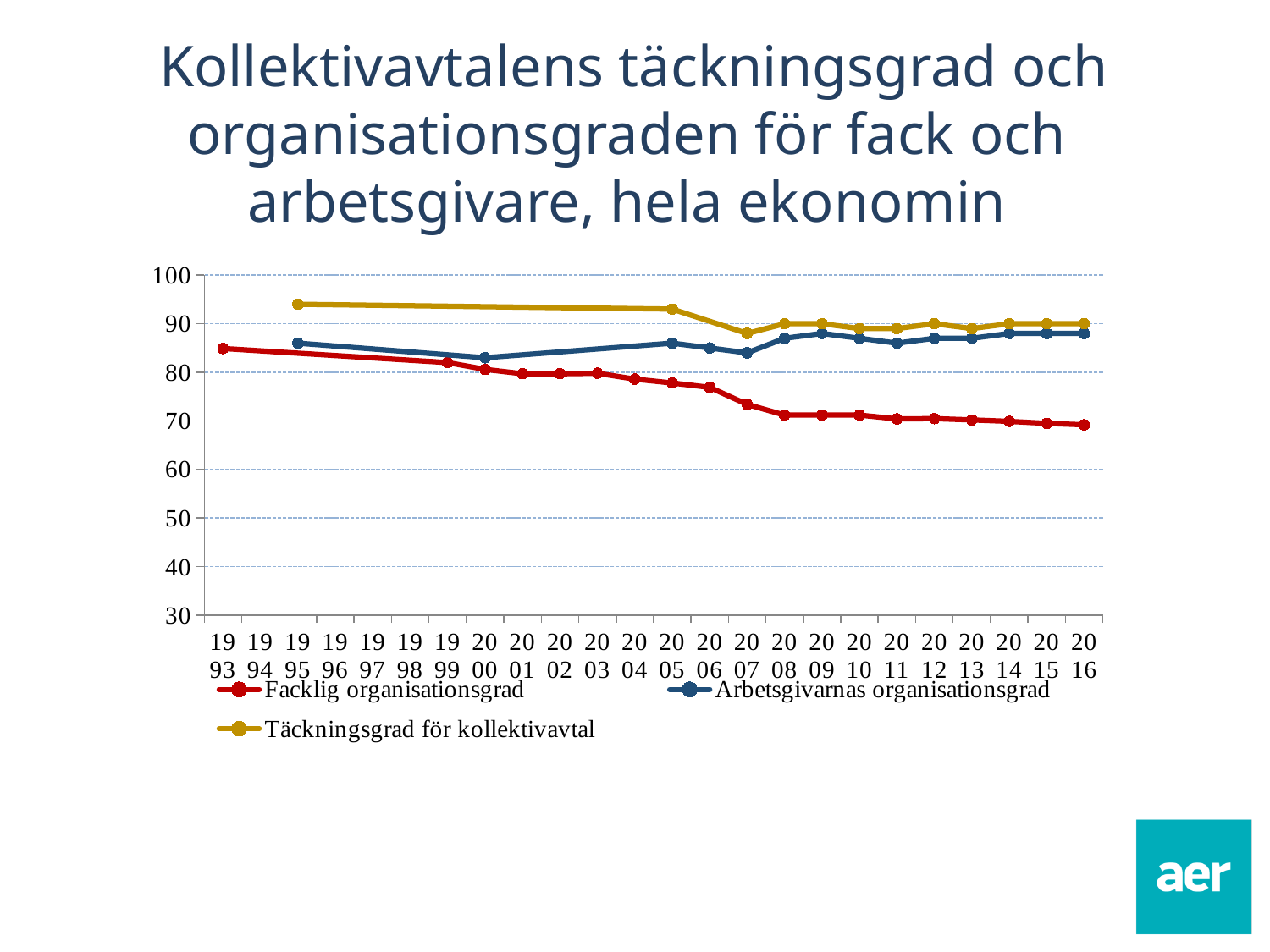
What is the first year shown on the x axis? 1993 What kind of chart is shown on the slide? line chart Does the Facklig organisationsgrad line rise or fall from 1993 to 2016? fall Is the value for Täckningsgrad för kollektivavtal in 1995 greater or less than 90? greater Which series has the highest value in 2016? Täckningsgrad för kollektivavtal Which series is drawn in red? Facklig organisationsgrad How many series does the legend list? 3 In 2010, which is larger: Arbetsgivarnas organisationsgrad or Facklig organisationsgrad? Arbetsgivarnas organisationsgrad Which series has the lowest value in 2016? Facklig organisationsgrad How many years are shown on the x axis? 24 Is the value for Arbetsgivarnas organisationsgrad in 2000 greater or less than 80? greater Is the value for Facklig organisationsgrad in 2008 greater or less than 80? less